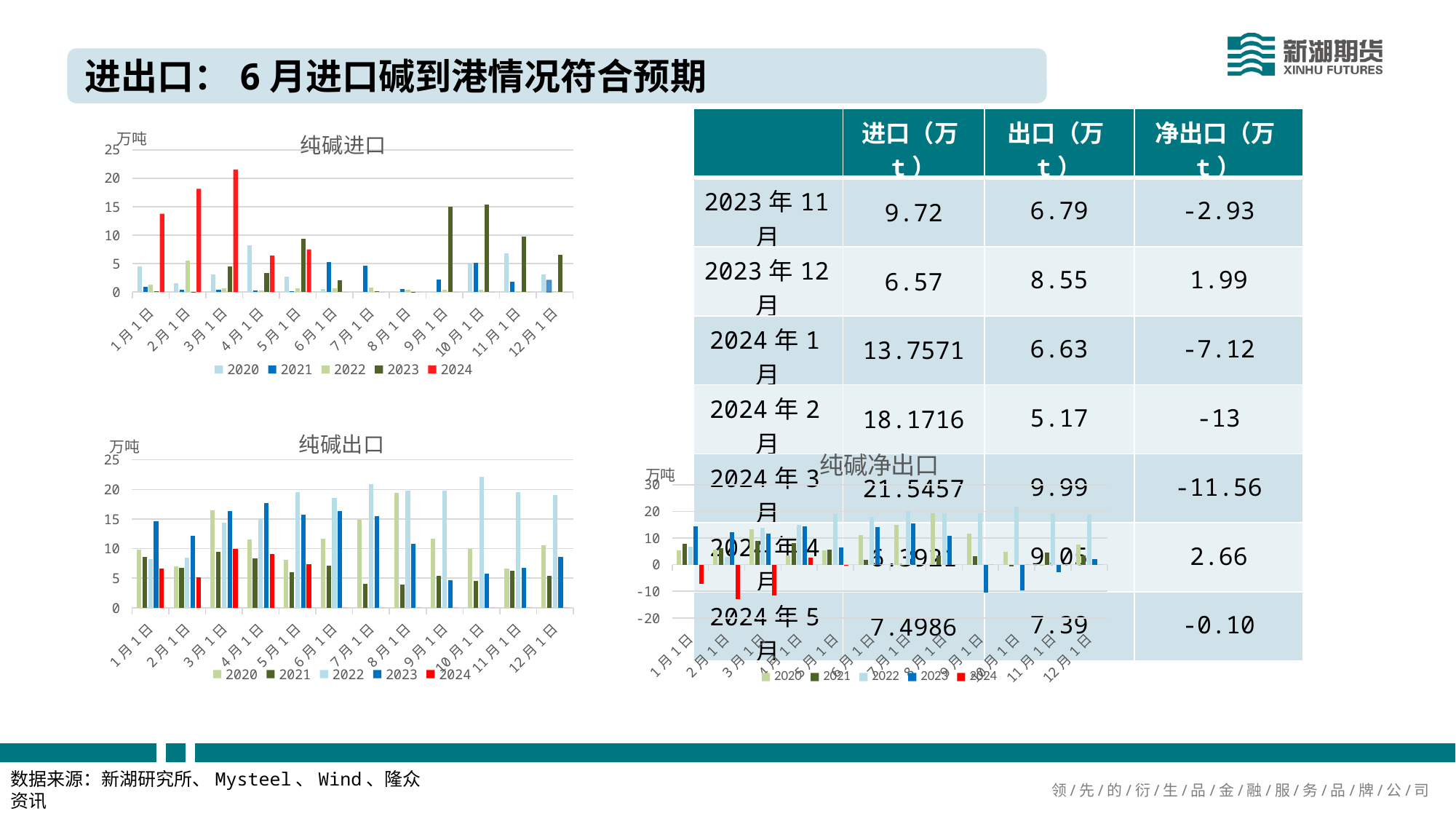
In the 纯碱进口 chart, is the 2023 value for 9月1日 greater or less than 10? greater In the 纯碱进口 chart, in which month is the 2024 bar highest? 4月1日 In the 纯碱出口 chart, which is larger at 4月1日, the 2023 value or the 2024 value? 2023 In the 纯碱出口 chart, is the 2022 value for 10月1日 greater or less than 20? greater In the 纯碱进口 chart, is the 2024 value for 2月1日 greater or less than 10? greater What kind of chart is the 纯碱进口 chart? bar chart In the 纯碱进口 chart, which year has the highest bar at 4月1日? 2024 How many month categories are on the x axis of the 纯碱出口 chart? 12 In the 纯碱进口 chart, which is larger, the 2024 value for 3月1日 or the 2024 value for 5月1日? 3月1日 How many series does the legend of the 纯碱进口 chart list? 5